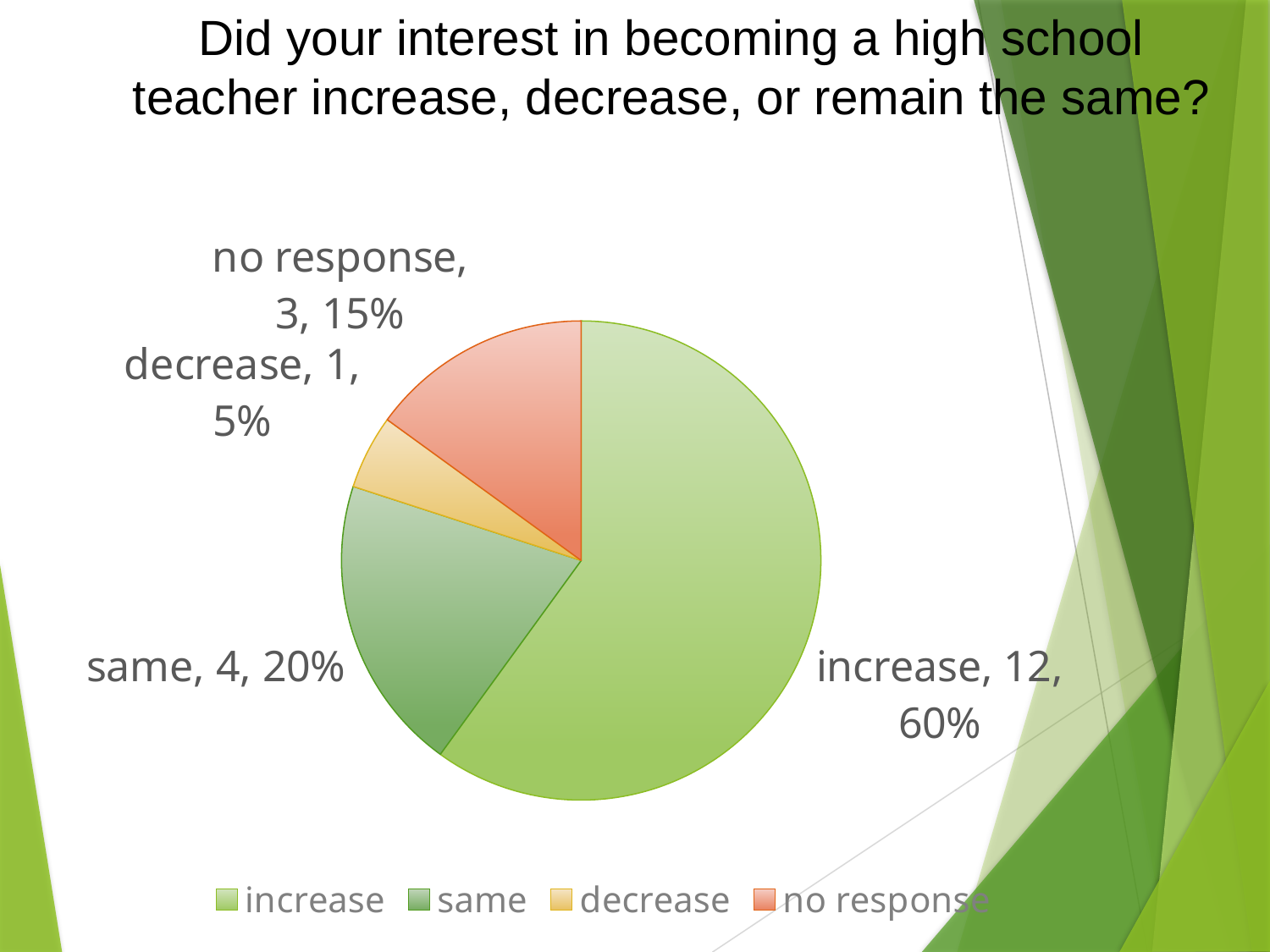
How many categories does the pie chart have? 4 Which category has the smallest slice of the pie? decrease What kind of chart is shown on the slide? pie chart What percentage of respondents said their interest remained the same? 20% What colour is the 'no response' slice? red How many more respondents said 'increase' than 'same'? 8 What share of the pie does the 'decrease' slice represent? 5% How many respondents gave no response? 3 Which is larger, the 'same' slice or the 'no response' slice? same Which category has the largest slice of the pie? increase How many respondents said their interest increased? 12 What is the total number of respondents across all slices? 20